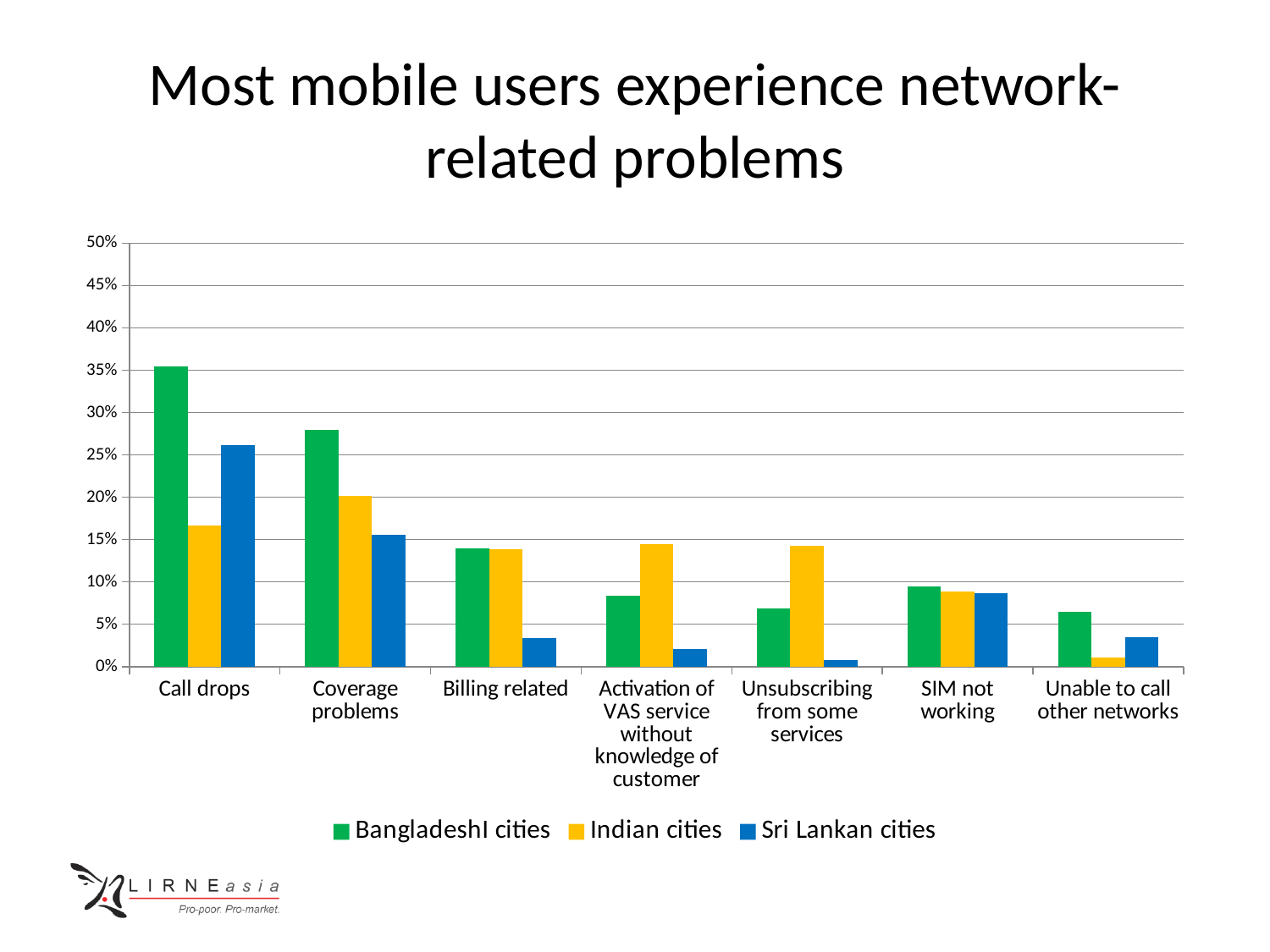
How many problem categories are shown on the x axis? 7 Is the value for Sri Lankan cities for Coverage problems greater or less than 20%? less For Activation of VAS service without knowledge of customer, which is larger: the value for Indian cities or the value for Bangladeshi cities? Indian cities For Sri Lankan cities, which problem category has the lowest value? Unsubscribing from some services For Indian cities, which problem category has the highest value? Coverage problems What colour represents Indian cities in the legend? yellow Is the value for Indian cities for Call drops greater or less than 20%? less Is the value for Bangladeshi cities for Call drops greater or less than 30%? greater What kind of chart is shown on the slide? bar chart For Bangladeshi cities, which problem category has the highest value? Call drops How many series does the legend list? 3 For Call drops, which is larger: the value for Sri Lankan cities or the value for Indian cities? Sri Lankan cities